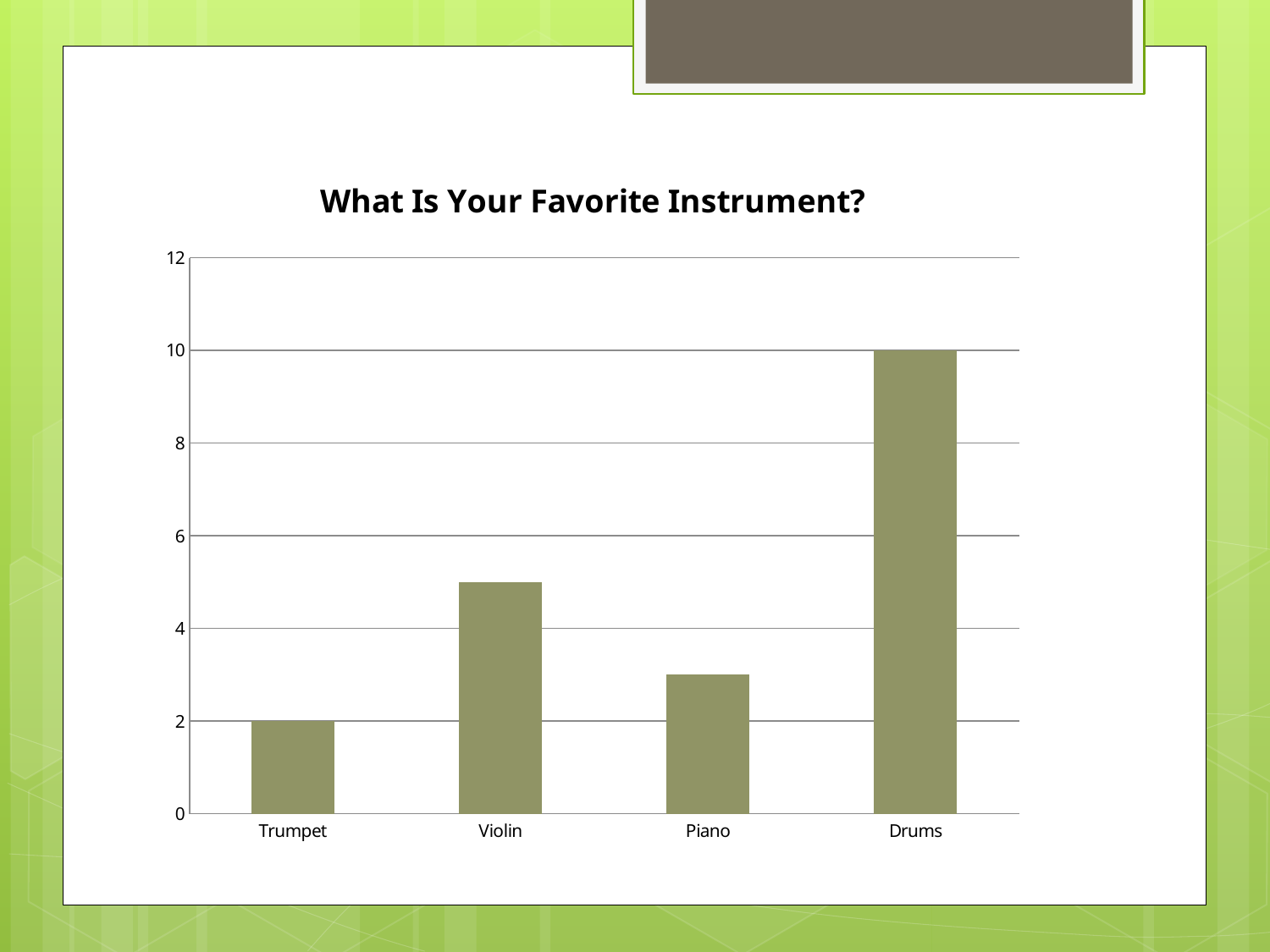
What is the title of the chart? What Is Your Favorite Instrument? Which has a larger value, Violin or Piano? Violin What is the value for Trumpet? 2 What is the difference between the values for Drums and Trumpet? 8 Is the value for Violin greater or less than 4? greater Which instrument has the lowest value? Trumpet Which has a larger value, Drums or Violin? Drums Which instrument has the highest value? Drums What is the value for Drums? 10 Is the value for Piano greater or less than 4? less What kind of chart is shown on the slide? bar chart How many instrument categories are shown on the x axis? 4